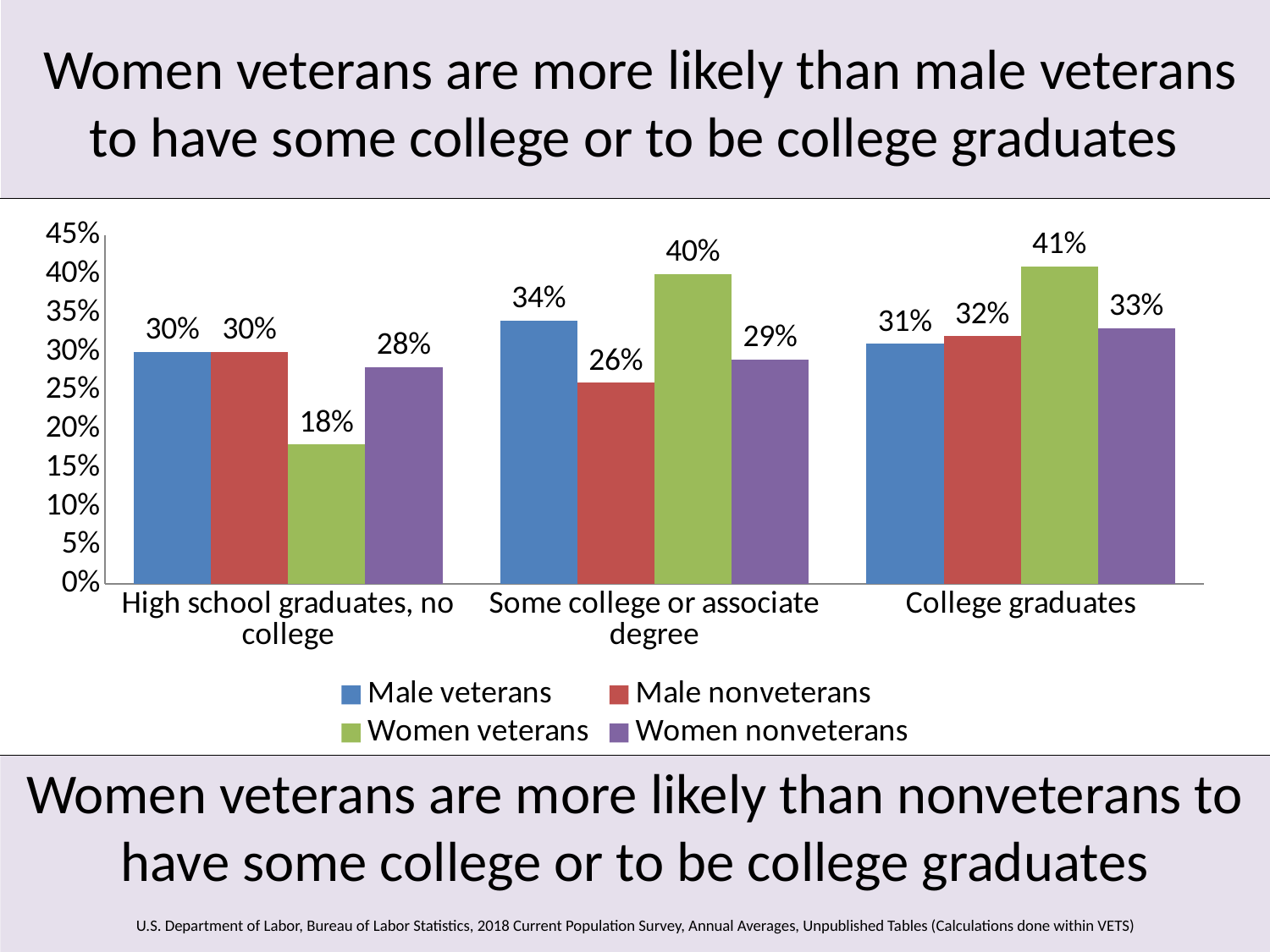
What is the value for Women veterans in the Some college or associate degree category? 40% Which series has the lowest value in the High school graduates, no college category? Women veterans What is the difference between Women veterans and Male veterans in the Some college or associate degree category? 6% What is the value for Male nonveterans in the College graduates category? 32% How many series does the legend list? 4 What kind of chart is shown on the slide? Bar chart What is the value for Women veterans in the High school graduates, no college category? 18% Which series has the highest value in the College graduates category? Women veterans What colour represents Women veterans in the chart? Green Do the values for Women veterans rise or fall across the categories from left to right? Rise Which is larger in the College graduates category: Women nonveterans or Male veterans? Women nonveterans How many categories are shown on the x axis? 3